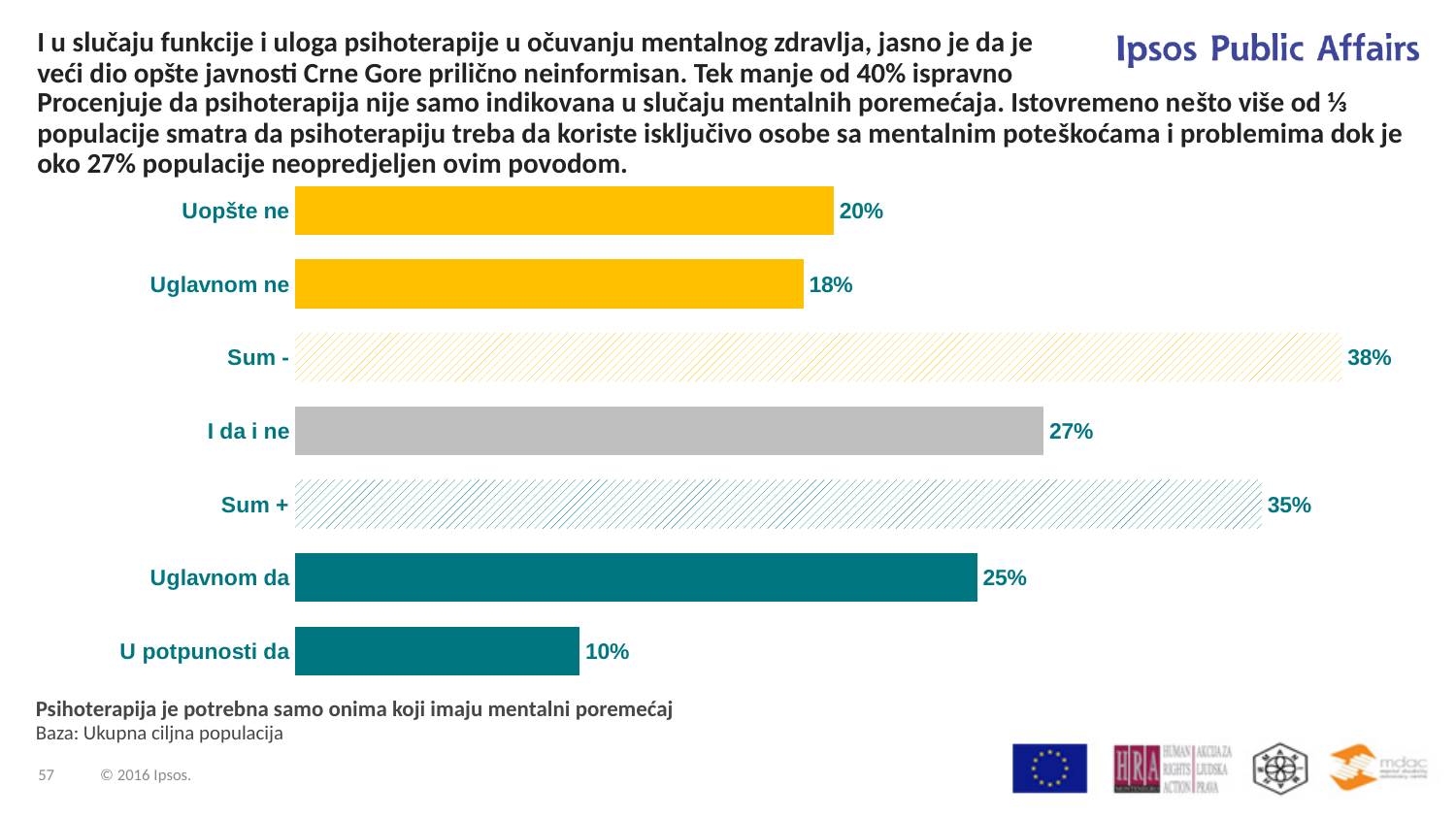
What kind of chart is shown on the slide? Bar chart How many bars are shown in the chart? 7 What is the value for "I da i ne"? 27% What is the value for "Sum +"? 35% What is the difference between "Sum -" and "Sum +"? 3% What is the value for "U potpunosti da"? 10% What is the value for "Uglavnom ne"? 18% Which category has the lowest value? U potpunosti da Which category has the highest value? Sum - Which is larger, "Uglavnom da" or "Uglavnom ne"? Uglavnom da What is the value for "Uopšte ne"? 20% What statement is the chart about, as written below the bars? Psihoterapija je potrebna samo onima koji imaju mentalni poremećaj